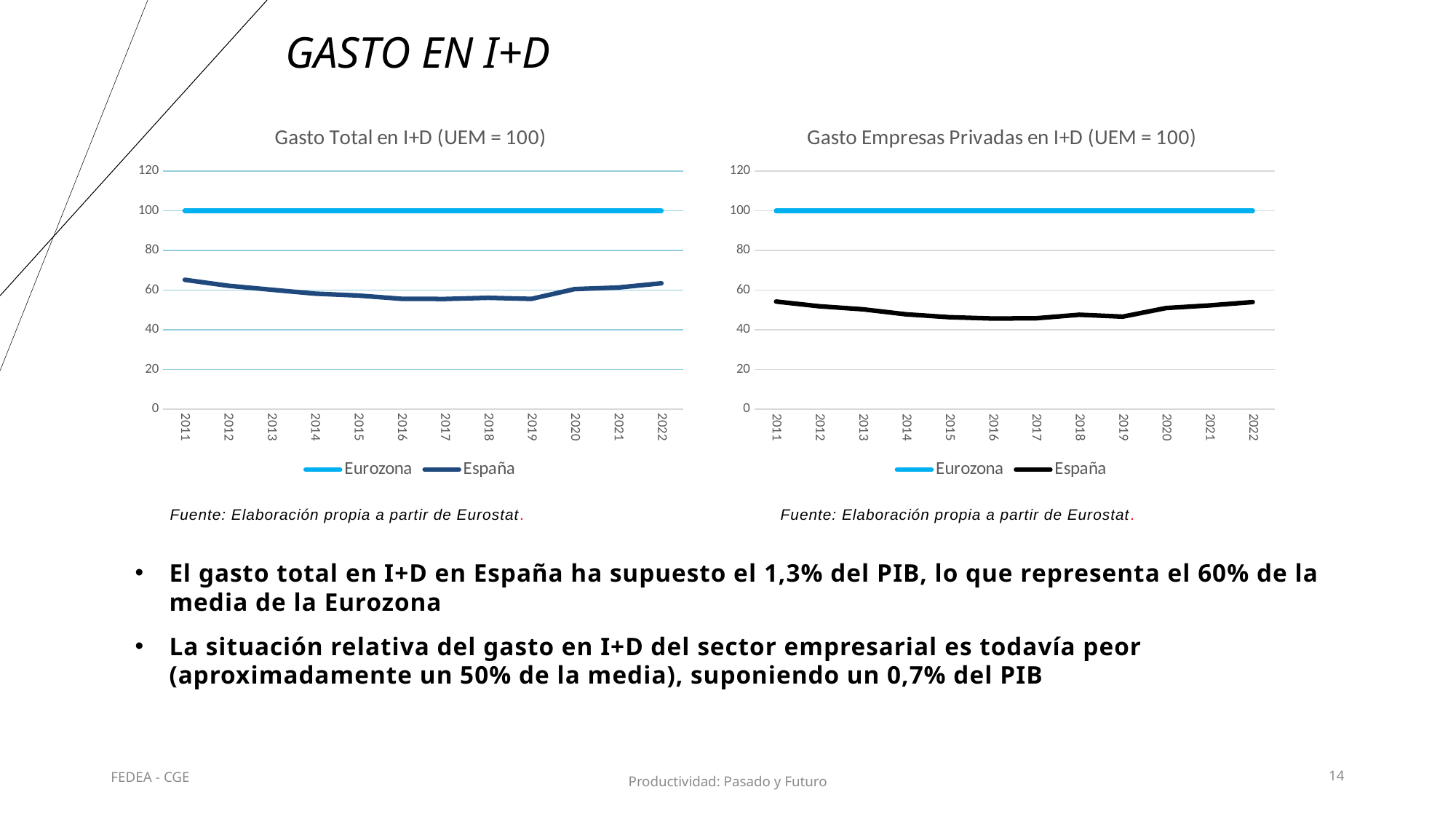
In the chart titled "Gasto Total en I+D (UEM = 100)", is the value for España in 2011 greater or less than 60? greater In the chart titled "Gasto Empresas Privadas en I+D (UEM = 100)", does the España series rise or fall between 2011 and 2016? fall In the chart titled "Gasto Total en I+D (UEM = 100)", what colour is the Eurozona line? light blue In the chart titled "Gasto Total en I+D (UEM = 100)", is the value for España in 2016 greater or less than 60? less In the chart titled "Gasto Empresas Privadas en I+D (UEM = 100)", how many series does the legend list? 2 In the chart titled "Gasto Empresas Privadas en I+D (UEM = 100)", is the value for España in 2016 greater or less than 60? less In the chart titled "Gasto Total en I+D (UEM = 100)", which series has the higher value in 2019, Eurozona or España? Eurozona In the chart titled "Gasto Empresas Privadas en I+D (UEM = 100)", what is the value of the Eurozona series in 2022? 100 In the chart titled "Gasto Total en I+D (UEM = 100)", what is the value of the Eurozona series in 2015? 100 In the chart titled "Gasto Total en I+D (UEM = 100)", how many years are shown on the x axis? 12 In the chart titled "Gasto Total en I+D (UEM = 100)", what kind of chart is shown? line chart